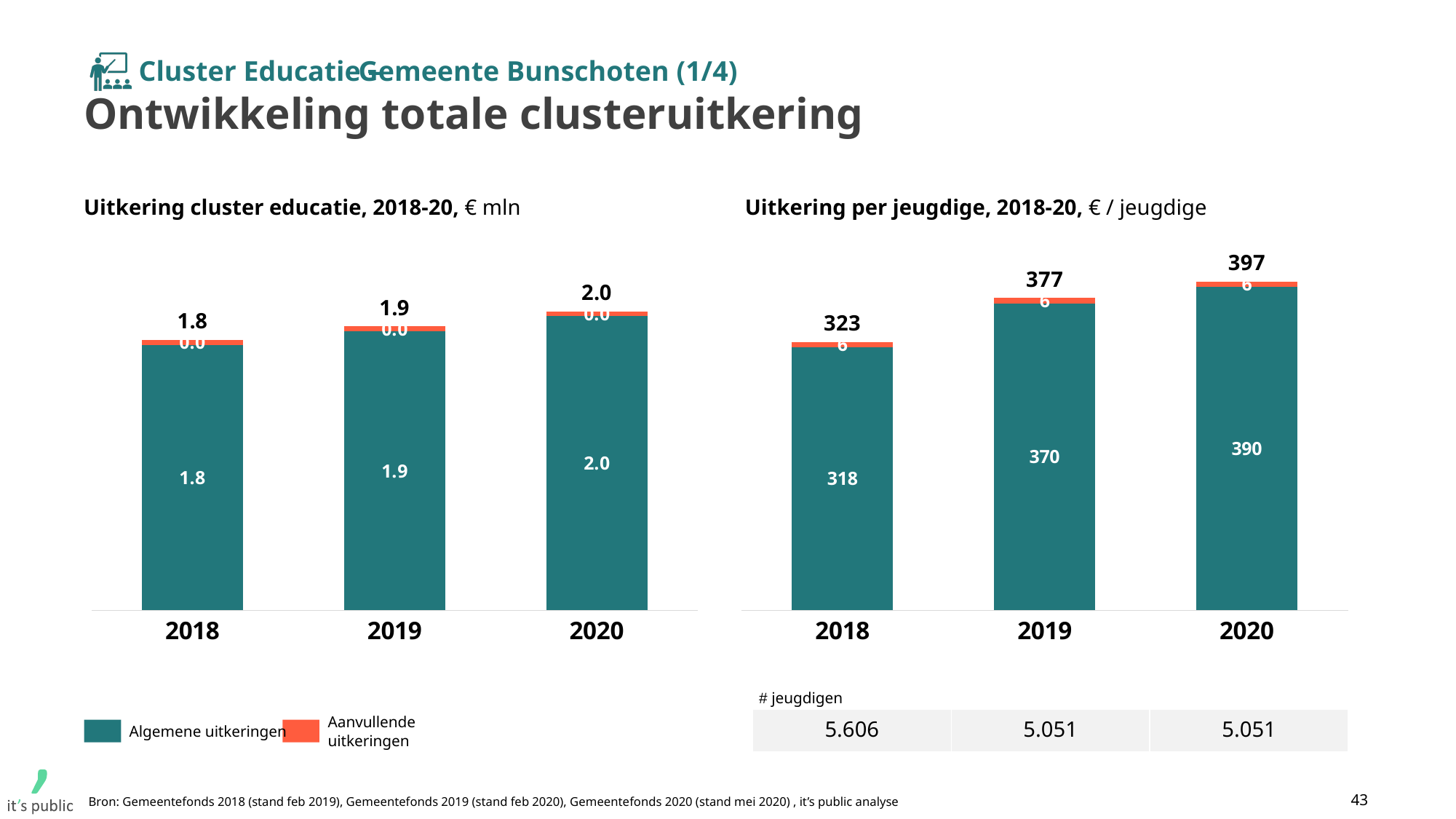
In the chart 'Uitkering per jeugdige, 2018-20', what is the value of Algemene uitkeringen for 2020? 390 In the chart 'Uitkering per jeugdige, 2018-20', what is the difference between the totals for 2020 and 2018? 74 In the chart 'Uitkering cluster educatie, 2018-20', what is the value of Algemene uitkeringen for 2018? 1.8 How many series does the legend list for the charts on this slide? 2 In the chart 'Uitkering per jeugdige, 2018-20', is the Algemene uitkeringen value larger in 2019 or in 2018? 2019 In the chart 'Uitkering per jeugdige, 2018-20', which year has the lowest total? 2018 In the chart 'Uitkering per jeugdige, 2018-20', which year has the highest total? 2020 What kind of chart is 'Uitkering per jeugdige, 2018-20'? Stacked bar chart In the chart 'Uitkering per jeugdige, 2018-20', what is the value of Aanvullende uitkeringen for 2018? 6 How many years are shown on the x axis of the chart 'Uitkering cluster educatie, 2018-20'? 3 In the chart 'Uitkering per jeugdige, 2018-20', what is the total value for 2019? 377 In the chart 'Uitkering cluster educatie, 2018-20', what is the total value for 2020? 2.0